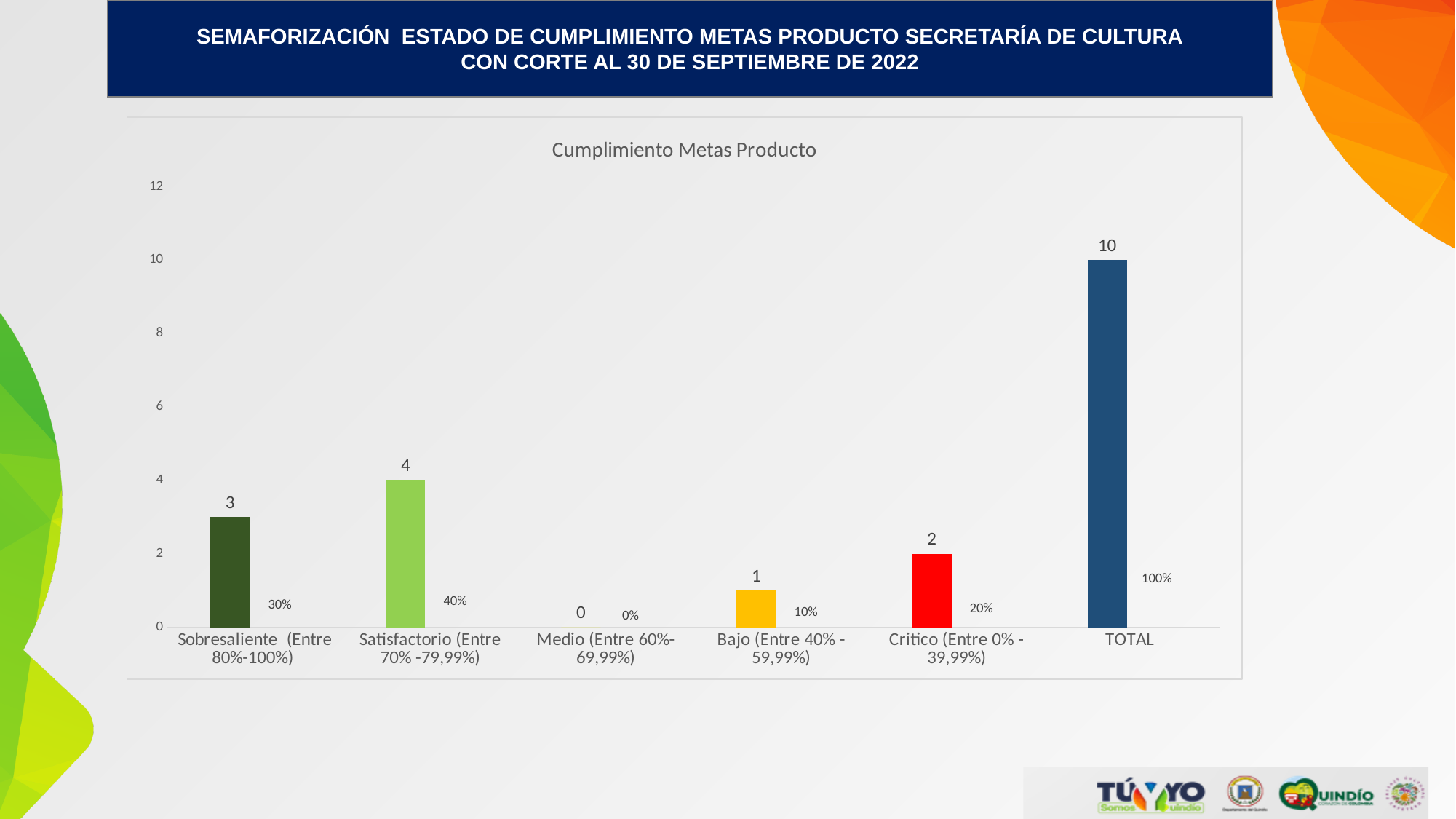
Which is larger, the value for Sobresaliente (Entre 80%-100%) or Critico (Entre 0% - 39,99%)? Sobresaliente (Entre 80%-100%) Is the value for TOTAL greater or less than 8? greater What is the value for Critico (Entre 0% - 39,99%)? 2 What kind of chart is shown? bar chart What is the title of the chart? Cumplimiento Metas Producto What is the value for Satisfactorio (Entre 70% -79,99%)? 4 What is the difference between the values for Satisfactorio (Entre 70% -79,99%) and Bajo (Entre 40% - 59,99%)? 3 Excluding TOTAL, which category has the highest value? Satisfactorio (Entre 70% -79,99%) Which category has the lowest value? Medio (Entre 60%-69,99%) What percentage is shown next to the Sobresaliente (Entre 80%-100%) bar? 30% What is the value for TOTAL? 10 How many categories are shown on the x axis? 6